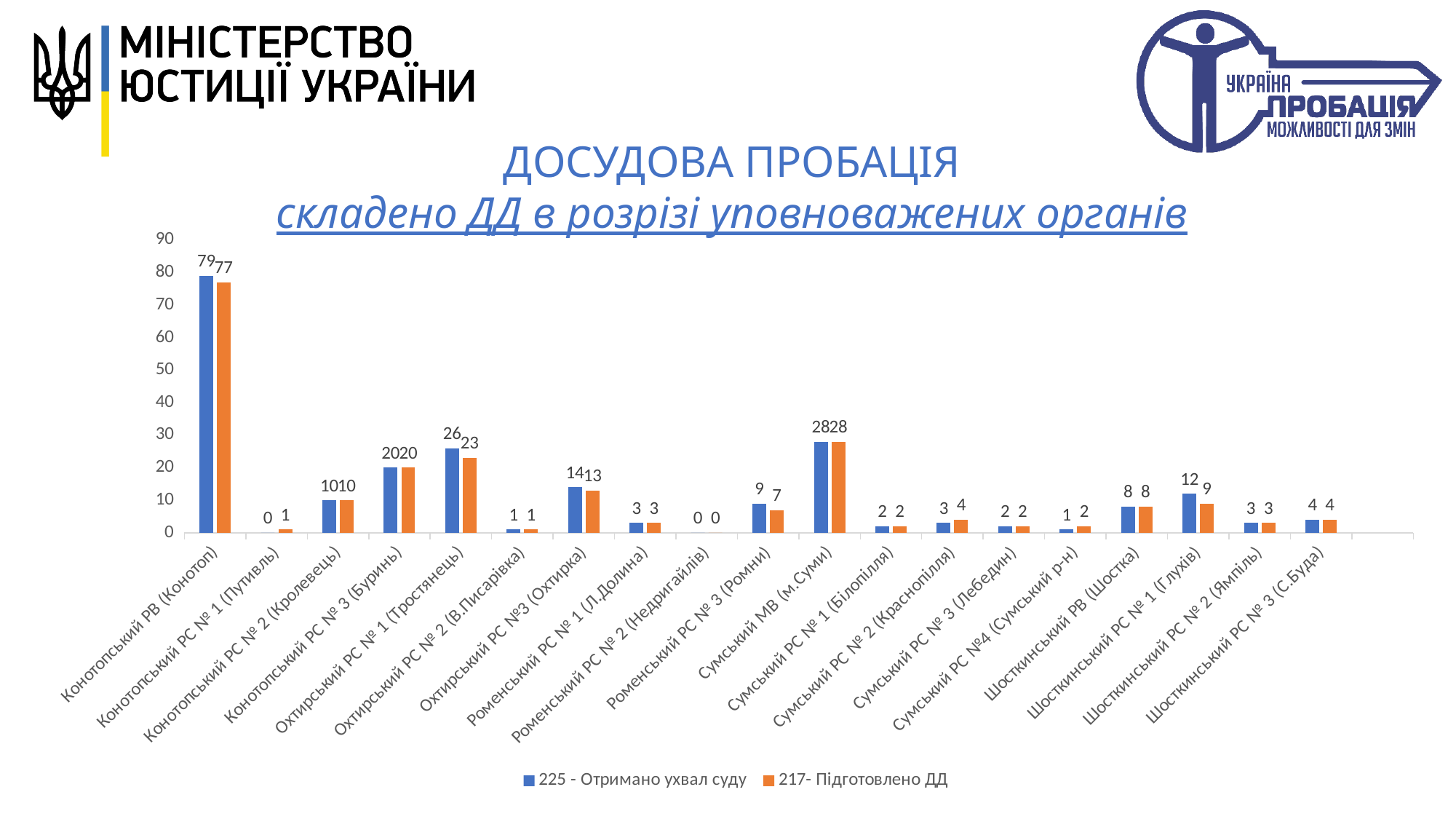
Which category has the highest value for "225 - Отримано ухвал суду"? Конотопський РВ (Конотоп) Which is larger for Сумський РС № 2 (Краснопілля): "225 - Отримано ухвал суду" or "217- Підготовлено ДД"? 217- Підготовлено ДД What is the difference between "225 - Отримано ухвал суду" and "217- Підготовлено ДД" for Шосткинський РС № 1 (Глухів)? 3 What type of chart is shown on the slide? bar chart How many series does the legend list? 2 What is the value of "217- Підготовлено ДД" for Роменський РС № 3 (Ромни)? 7 How many categories (authorized bodies) are shown on the x axis? 19 Is the value of "217- Підготовлено ДД" for Конотопський РВ (Конотоп) greater or less than 70? greater What is the value of "217- Підготовлено ДД" for Охтирський РС № 1 (Тростянець)? 23 What colour are the bars for the series "217- Підготовлено ДД"? orange What is the value of "225 - Отримано ухвал суду" for Конотопський РВ (Конотоп)? 79 What is the difference between the "225 - Отримано ухвал суду" values for Сумський МВ (м.Суми) and Охтирський РС № 1 (Тростянець)? 2